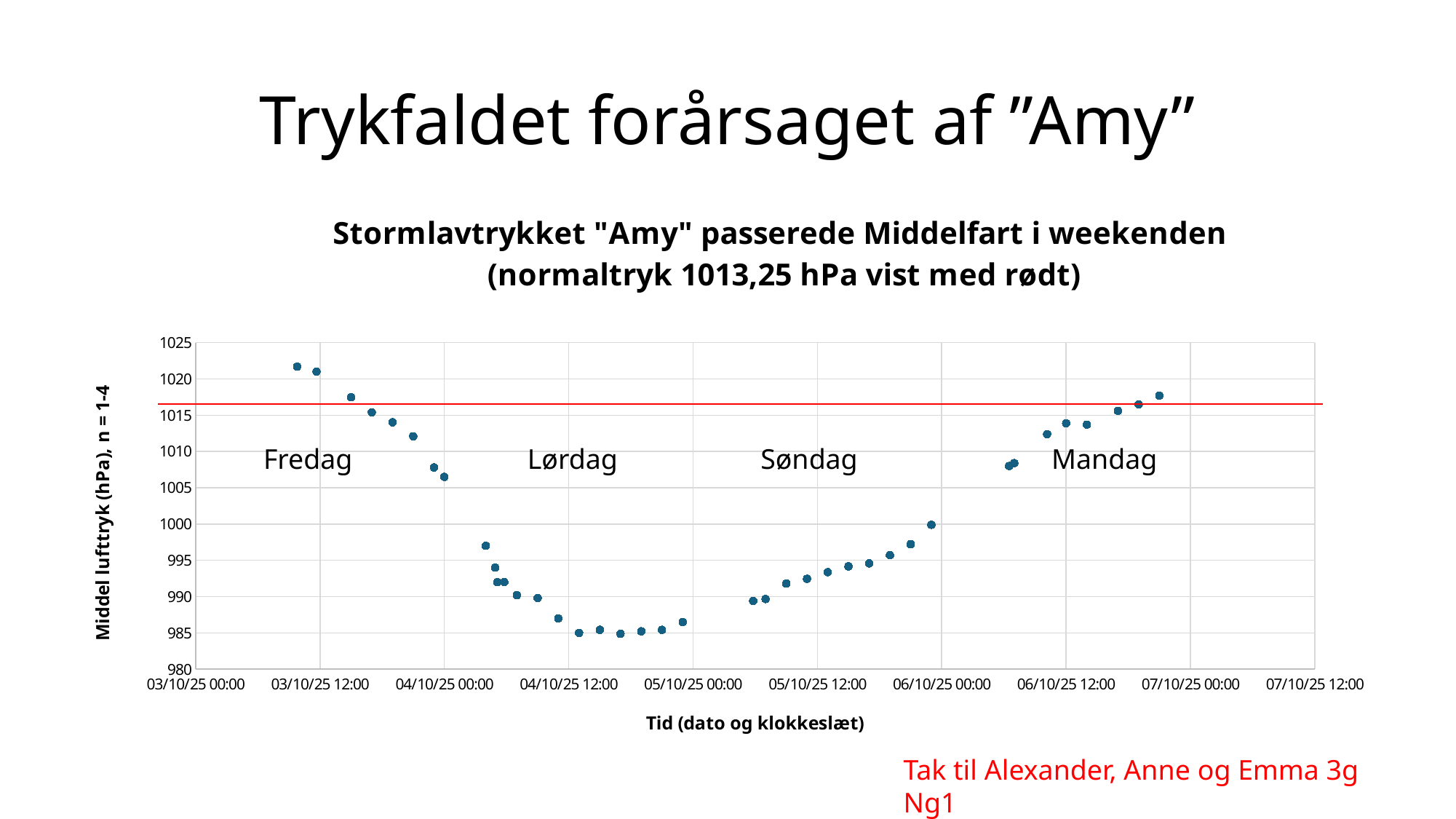
Is the pressure value at about 05/10/25 12:00 greater or less than 1000? less On which labelled day does the pressure reach its lowest values? Lørdag On which labelled day does the pressure reach its highest values? Fredag Do the pressure values rise or fall from Fredag to Lørdag? fall Is the pressure at about 03/10/25 12:00 higher or lower than at about 04/10/25 12:00? higher How many day labels (Fredag, Lørdag, Søndag, Mandag) are shown on the chart? 4 What is the title of the chart? Stormlavtrykket "Amy" passerede Middelfart i weekenden (normaltryk 1013,25 hPa vist med rødt) Is the first plotted pressure value (around 03/10/25 12:00) greater or less than 1020? greater According to the chart title, what does the red horizontal line represent? normaltryk 1013,25 hPa Are the lowest plotted pressure values (around 04/10/25 12:00) greater or less than 990? less What kind of chart is shown on the slide? scatter chart Do the pressure values rise or fall from Søndag to Mandag? rise